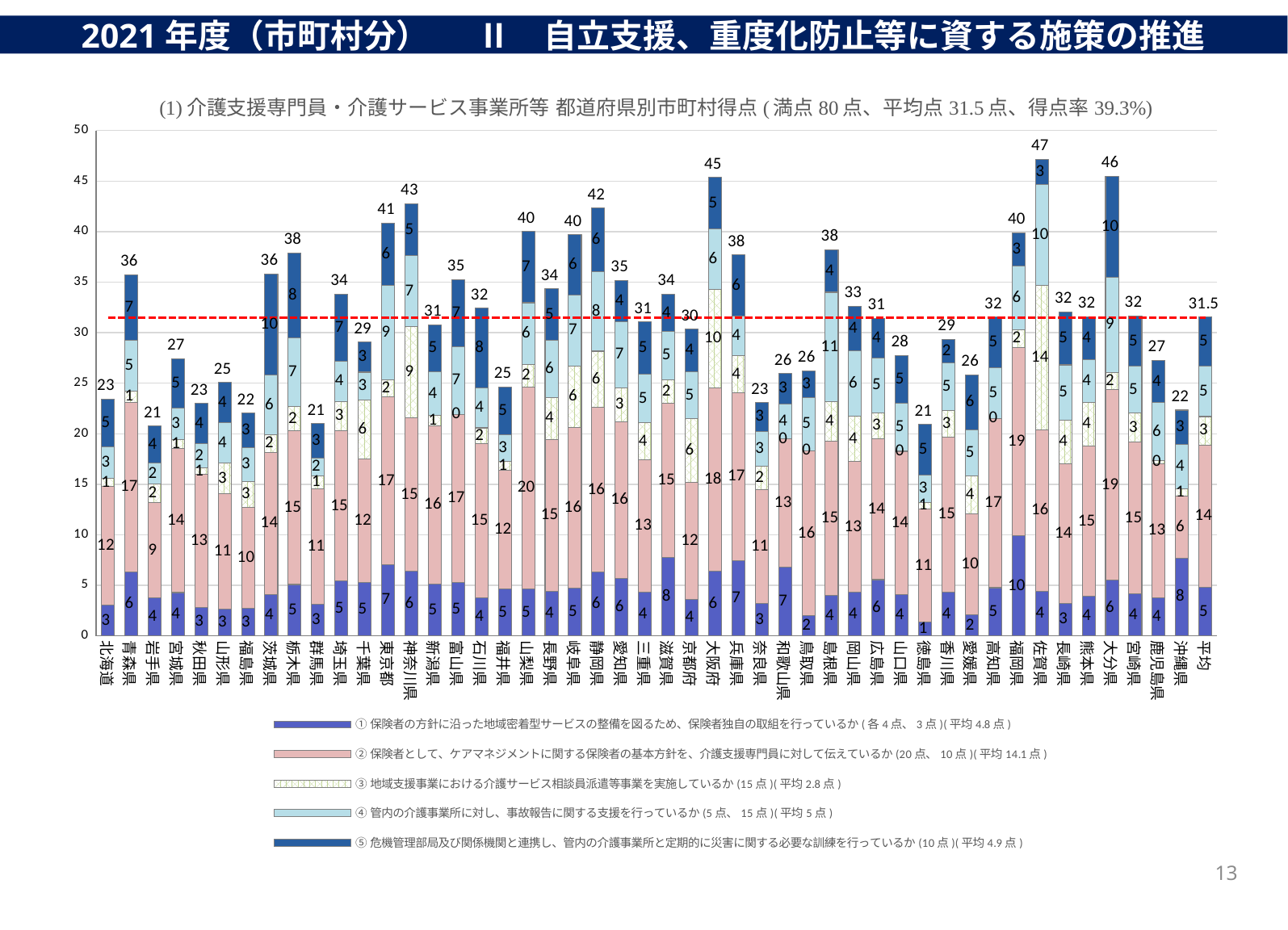
What kind of chart is shown on the slide? Stacked bar chart What value does the red dashed horizontal line represent? 31.5 (平均点) Which has a higher total score, 東京都 or 神奈川県? 神奈川県 What is the total score shown for 大阪府? 45 What is the difference between the total scores of 大阪府 and 北海道? 22 How many series does the legend list? 5 Is the total score for 沖縄県 greater or less than 25? less What is the difference between the total scores of 佐賀県 and 大分県? 1 What is the total score shown for 北海道? 23 What is the total score shown for 佐賀県? 47 What is the value of the ② segment (pink) for 山梨県? 20 Which prefecture has the highest total score? 佐賀県